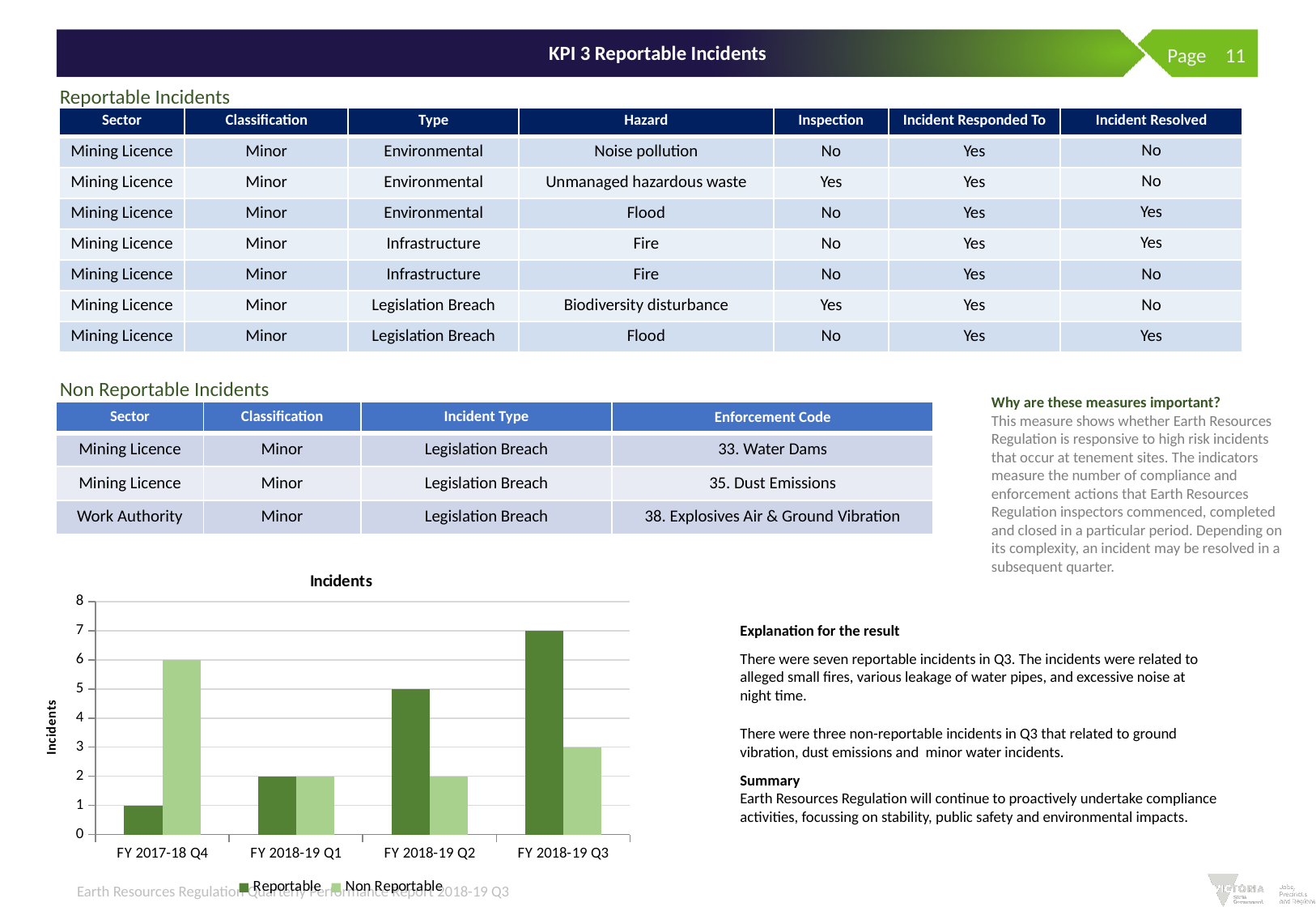
Which quarter has the highest Reportable value in the 'Incidents' chart? FY 2018-19 Q3 What is the Reportable value for FY 2018-19 Q3 in the 'Incidents' chart? 7 How many quarters are shown on the x axis of the 'Incidents' chart? 4 What is the Reportable value for FY 2018-19 Q2 in the 'Incidents' chart? 5 Which quarter has the lowest Reportable value in the 'Incidents' chart? FY 2017-18 Q4 In the 'Incidents' chart, what is the difference between the Reportable and Non Reportable values for FY 2018-19 Q3? 4 In the 'Incidents' chart, is the Reportable or the Non Reportable value larger for FY 2017-18 Q4? Non Reportable Do the Reportable values in the 'Incidents' chart rise or fall from FY 2017-18 Q4 to FY 2018-19 Q3? rise What is the Non Reportable value for FY 2018-19 Q3 in the 'Incidents' chart? 3 How many series does the legend of the 'Incidents' chart list? 2 What kind of chart is the 'Incidents' chart? bar chart What is the Non Reportable value for FY 2017-18 Q4 in the 'Incidents' chart? 6